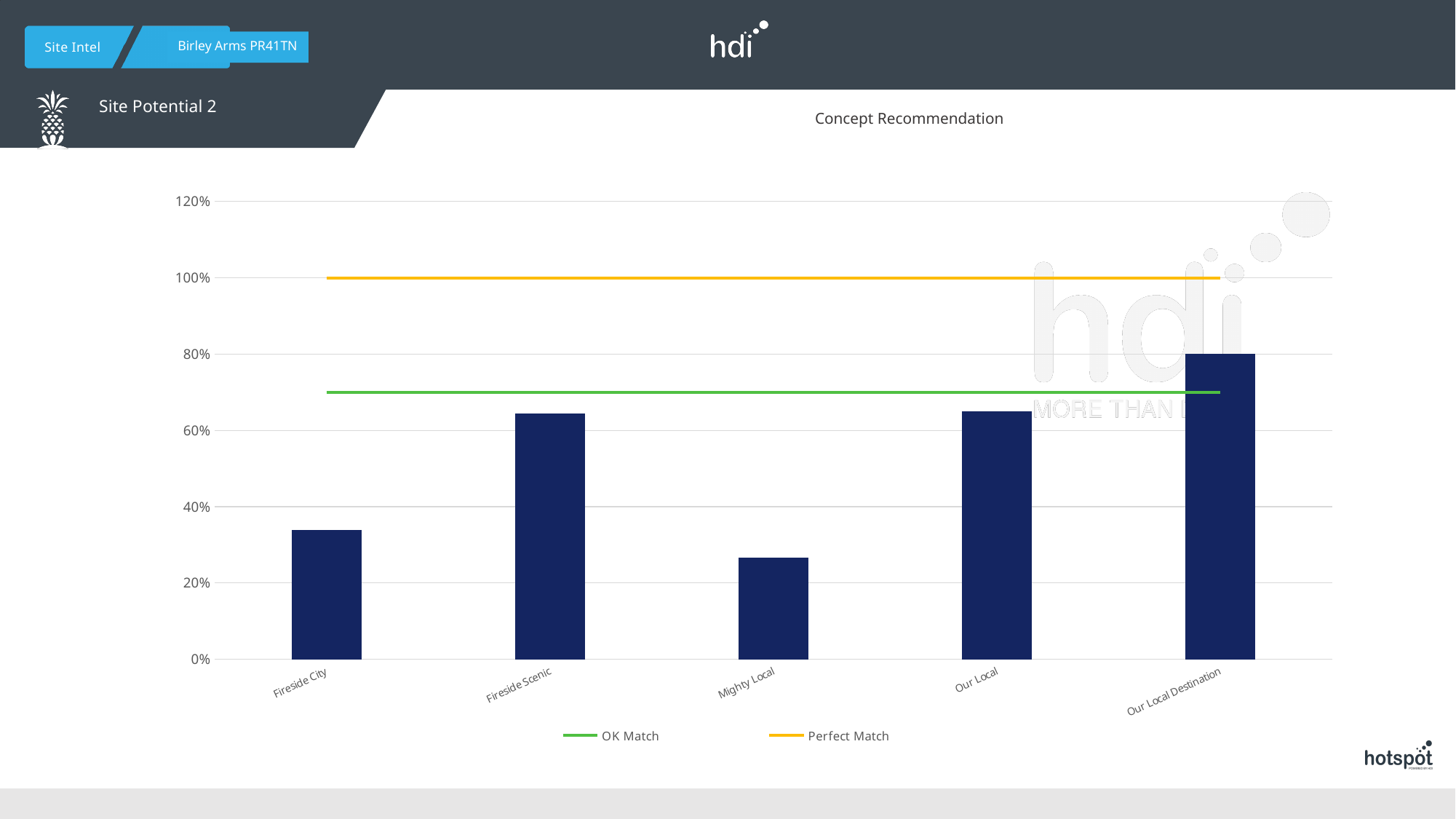
Which concept has the lowest bar? Mighty Local Is the value for Fireside City greater or less than 40%? less Which is larger, the bar for Fireside City or the bar for Mighty Local? Fireside City How many concept categories are shown on the x axis? 5 What kind of chart is shown on the slide? bar chart Is the value for Fireside Scenic greater or less than 60%? greater Which legend entry is shown with a yellow line? Perfect Match Is the value for Our Local greater or less than 80%? less How many entries does the legend list? 2 At what level is the Perfect Match line drawn? 100% Which concept has the highest bar? Our Local Destination What is the title of the chart? Concept Recommendation